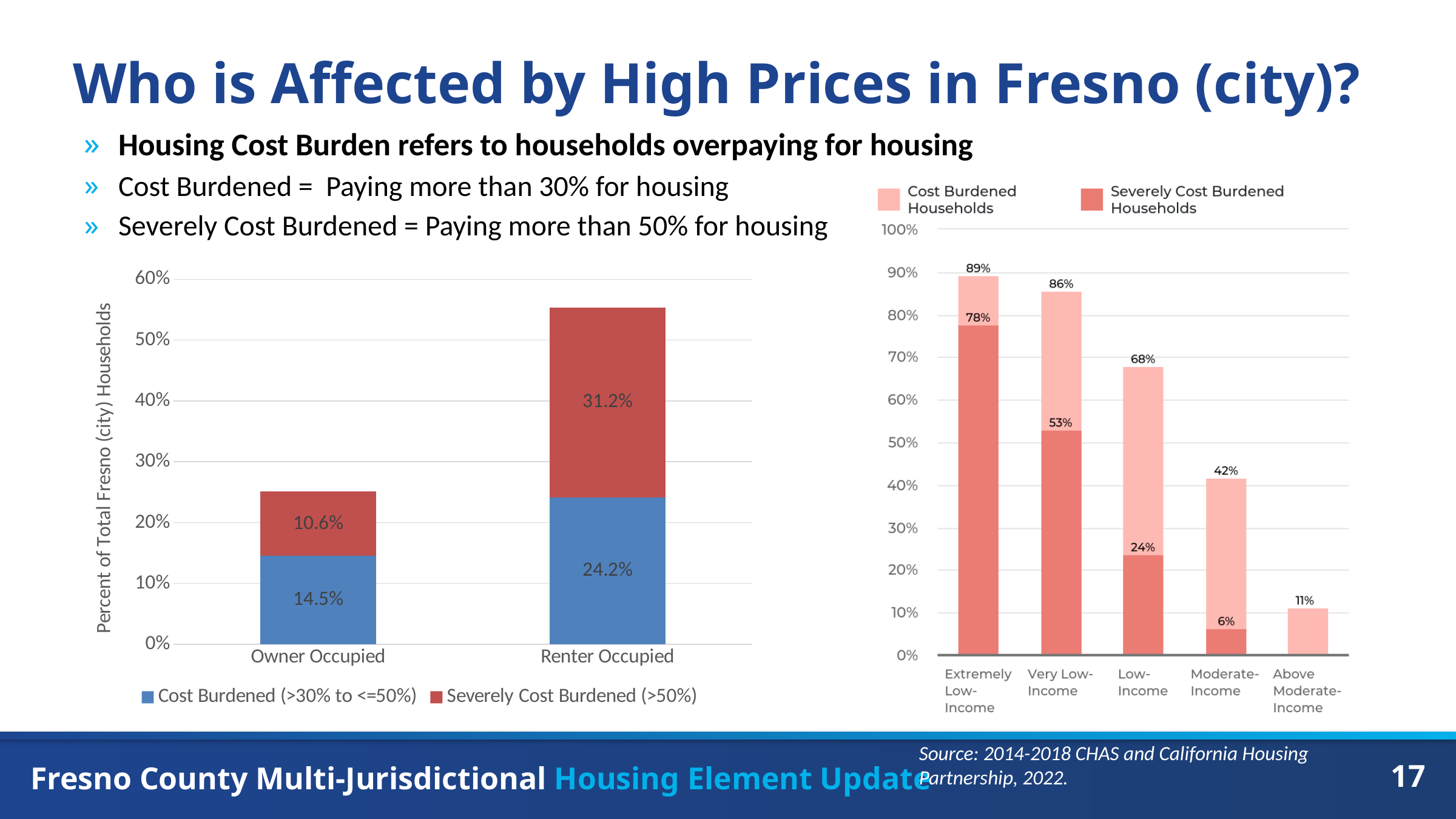
In the left chart, what is the total height of the Renter Occupied stacked bar? 55.4% In the left chart, what is the difference between the Severely Cost Burdened values for Renter Occupied and Owner Occupied households? 20.6% In the right chart, what is the Cost Burdened Households value for Very Low-Income? 86% In the left chart, what is the Severely Cost Burdened (>50%) value for Renter Occupied households? 31.2% In the left chart, what is the Cost Burdened (>30% to <=50%) value for Owner Occupied households? 14.5% In the right chart, how many income categories are shown on the x axis? 5 In the left chart, which category has the larger Cost Burdened (>30% to <=50%) value, Owner Occupied or Renter Occupied? Renter Occupied What kind of chart is the left chart? Stacked bar chart In the right chart, do the Cost Burdened Households values rise or fall moving from Extremely Low-Income to Above Moderate-Income? Fall In the right chart, which income category has the lowest Cost Burdened Households value? Above Moderate-Income In the right chart, what is the Severely Cost Burdened Households value for Low-Income? 24% In the left chart, how many series does the legend list? 2